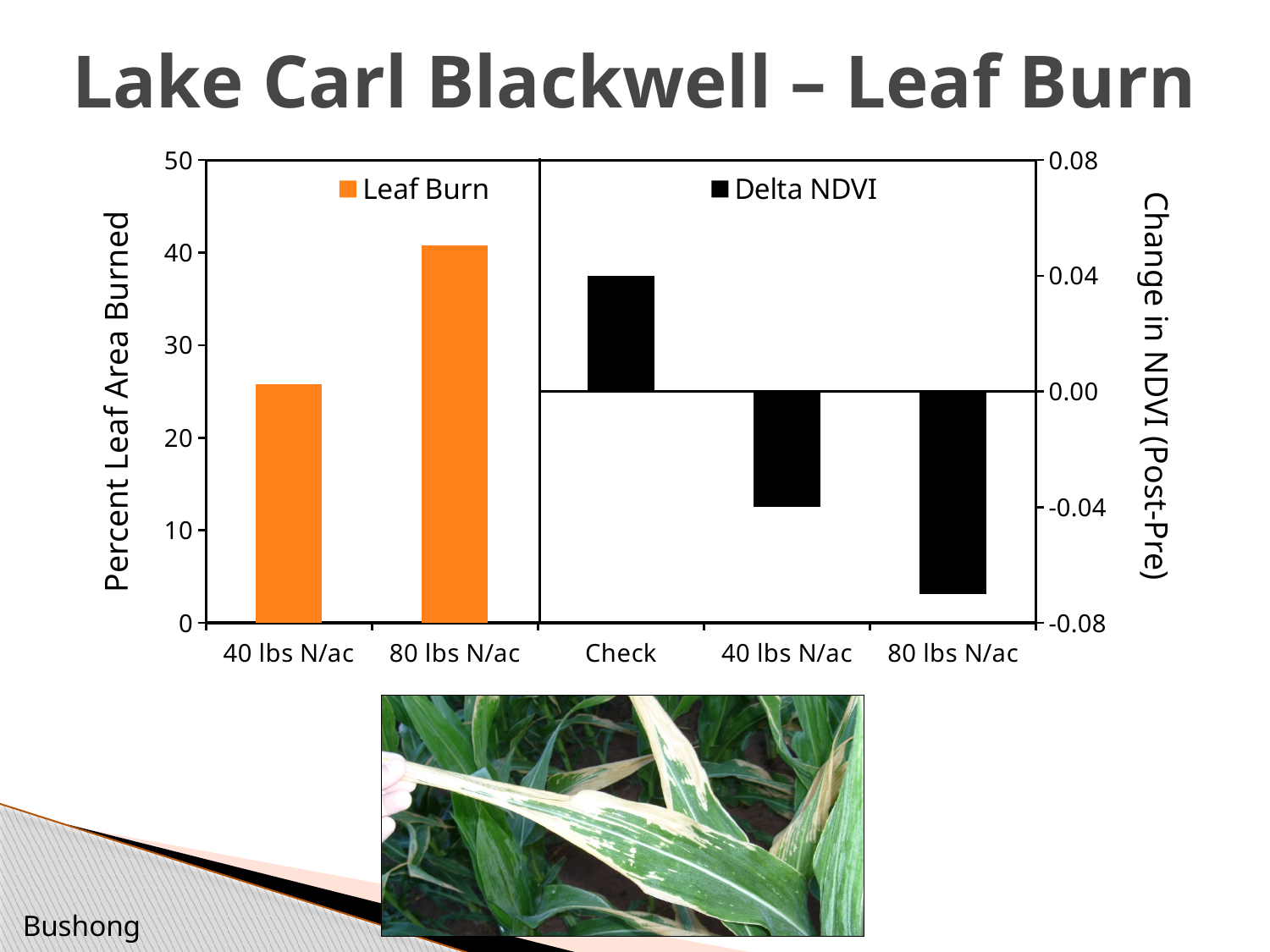
Which category has the highest Leaf Burn value? 80 lbs N/ac Which category has the lowest Delta NDVI value? 80 lbs N/ac Is the Leaf Burn value for 40 lbs N/ac greater or less than 30? less What is the label of the right-hand vertical axis? Change in NDVI (Post-Pre) What kind of chart is shown on the slide? bar chart How many series does the chart's legend list? 2 Is the Leaf Burn value for 80 lbs N/ac greater or less than 40? greater Which is larger, the Leaf Burn value for 40 lbs N/ac or for 80 lbs N/ac? 80 lbs N/ac Which category has the highest Delta NDVI value? Check How many categories are plotted for the Delta NDVI series? 3 Is the Delta NDVI value for 80 lbs N/ac greater or less than -0.04? less